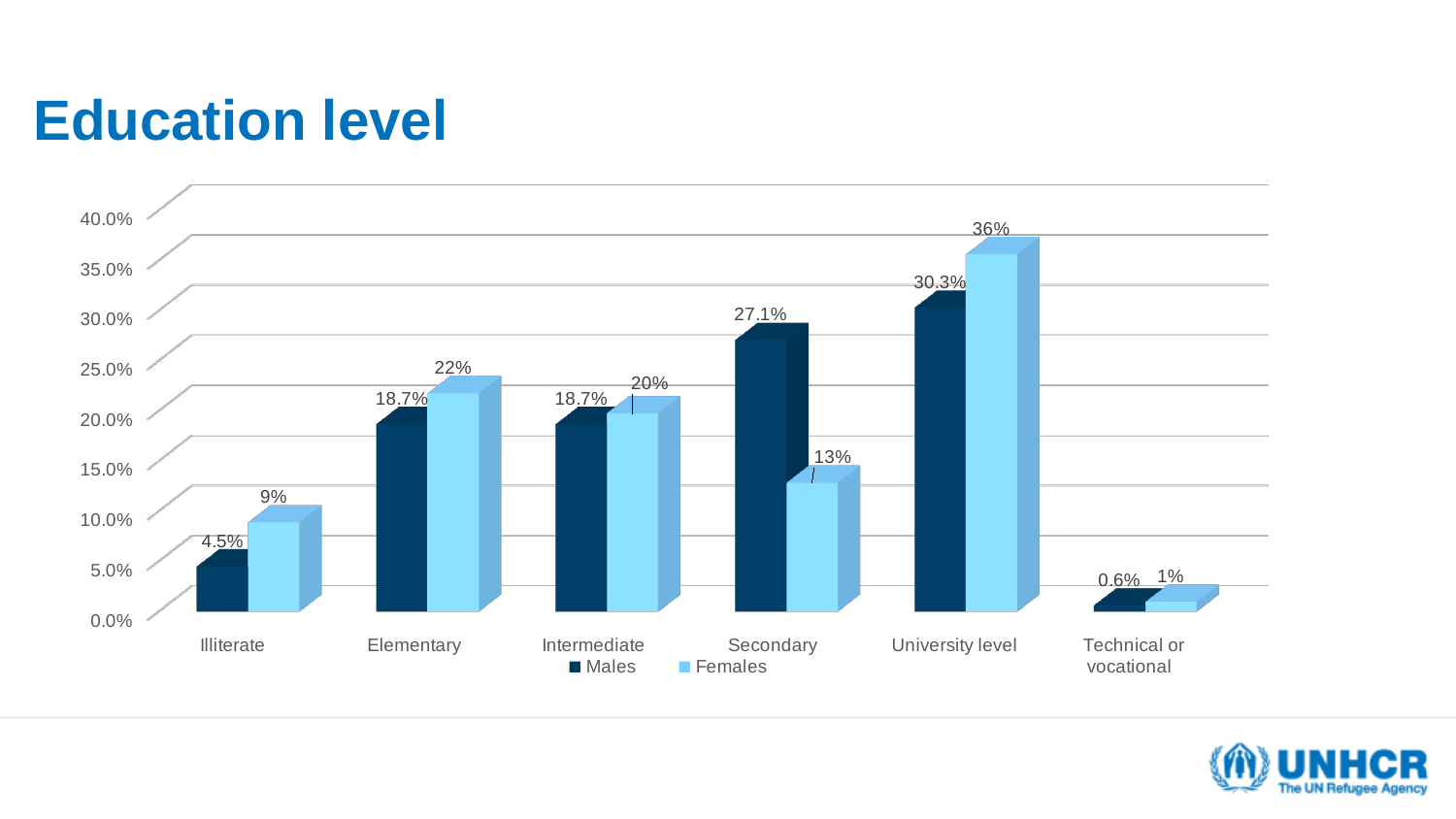
Which category has the lowest value for Females? Technical or vocational What is the difference between the Males and Females values in the Secondary category? 14.1% How many education level categories are shown on the x axis? 6 What is the difference between the Females values for University level and Illiterate? 27% What kind of chart is shown on the slide? Bar chart How many series does the legend list? 2 What is the title of the slide? Education level What is the value for Females in the University level category? 36% In the Elementary category, which is larger, the Males value or the Females value? Females What is the value for Males in the Secondary category? 27.1% What is the value for Females in the Illiterate category? 9% Which category has the highest value for Males? University level